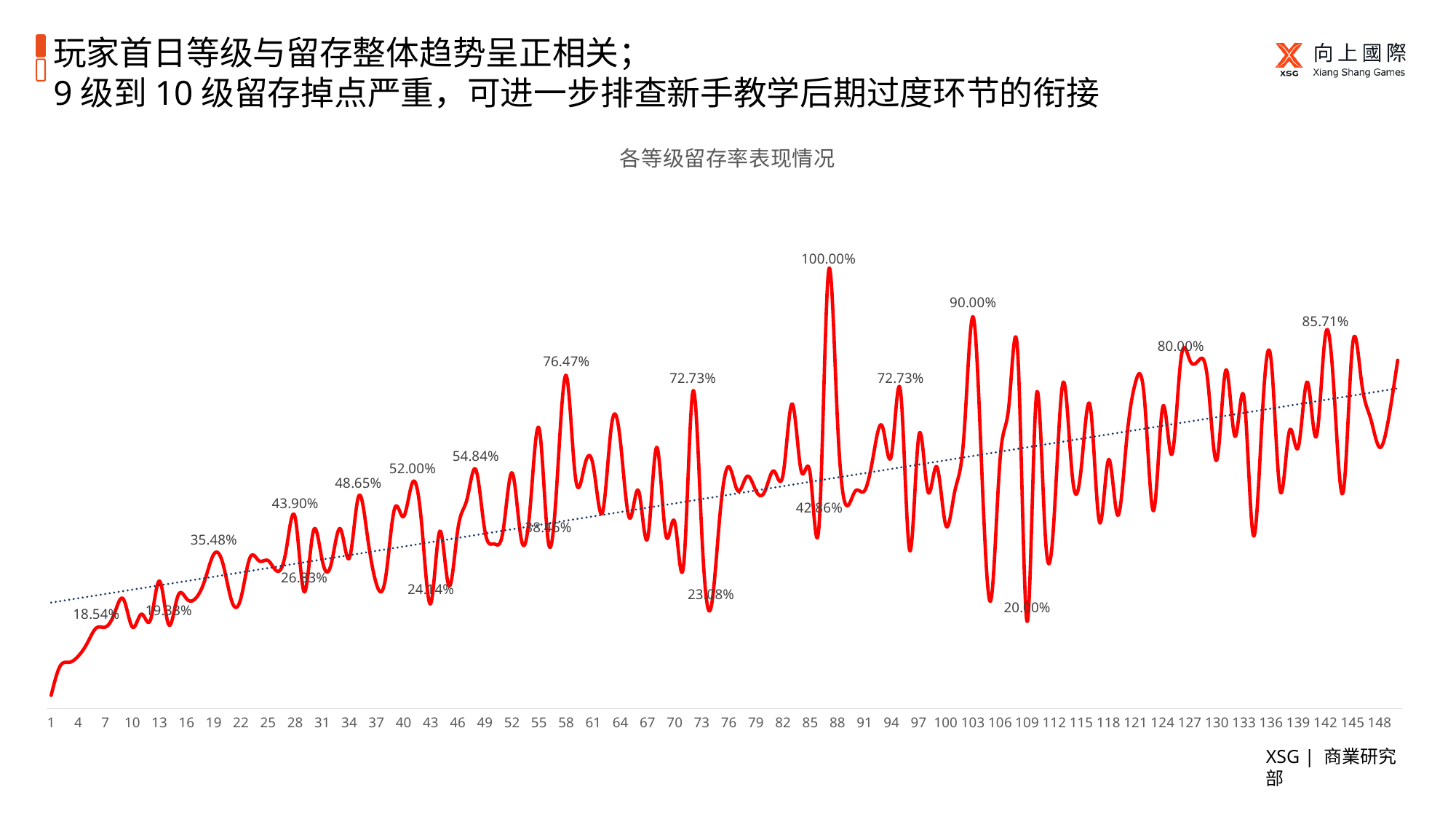
What is the difference between the labelled values 100.00% and 20.00%? 80.00% What is the first level shown on the x axis? 1 What is the difference between the labelled values 85.71% and 80.00%? 5.71% Which labelled value is larger, 43.90% or 48.65%? 48.65% What is the difference between the 100.00% peak and the 90.00% peak labelled on the chart? 10.00% Which labelled value is larger, 76.47% or 72.73%? 76.47% Besides the red data line, what other line is drawn on the chart? a dotted trend line What is the highest value labelled on the chart? 100.00% What is the last level label shown on the x axis? 148 What kind of chart is shown on the slide? line chart Overall, do the retention values rise or fall as the level increases along the x axis? rise What is the title of the chart? 各等级留存率表现情况